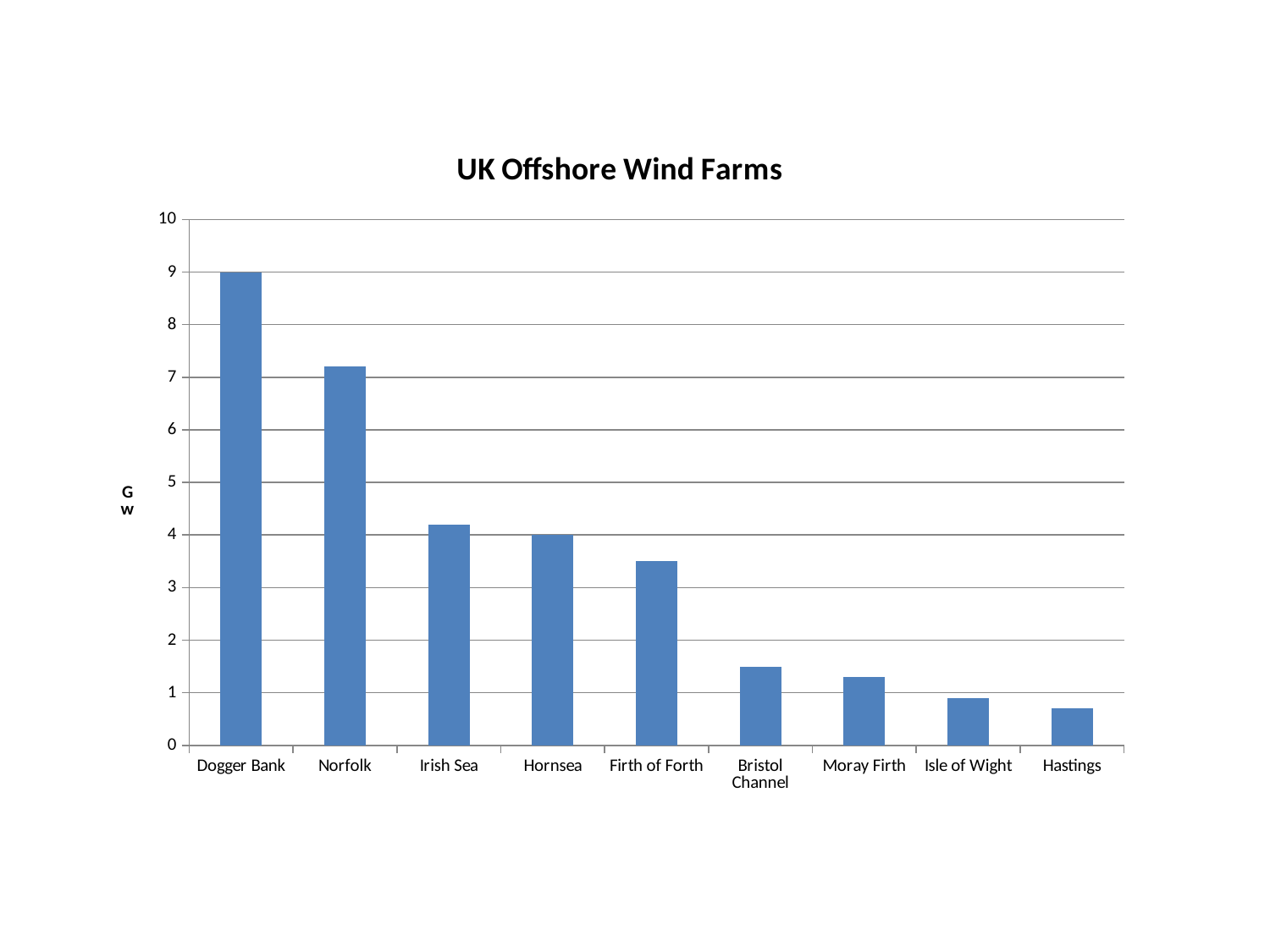
What is the value for Hornsea in GW? 4 Is the value for Norfolk greater or less than 7? greater What is the value for Dogger Bank in GW? 9 What kind of chart is shown on the slide? Bar chart What is the title of the chart? UK Offshore Wind Farms How many wind farm categories are shown on the x axis? 9 Which is larger, the value for Norfolk or the value for Irish Sea? Norfolk Is the value for Firth of Forth greater or less than 4? less Which wind farm has the highest value? Dogger Bank Which wind farm has the lowest value? Hastings Do the values rise or fall moving from left to right along the x axis? Fall Is the value for Isle of Wight greater or less than 1? less